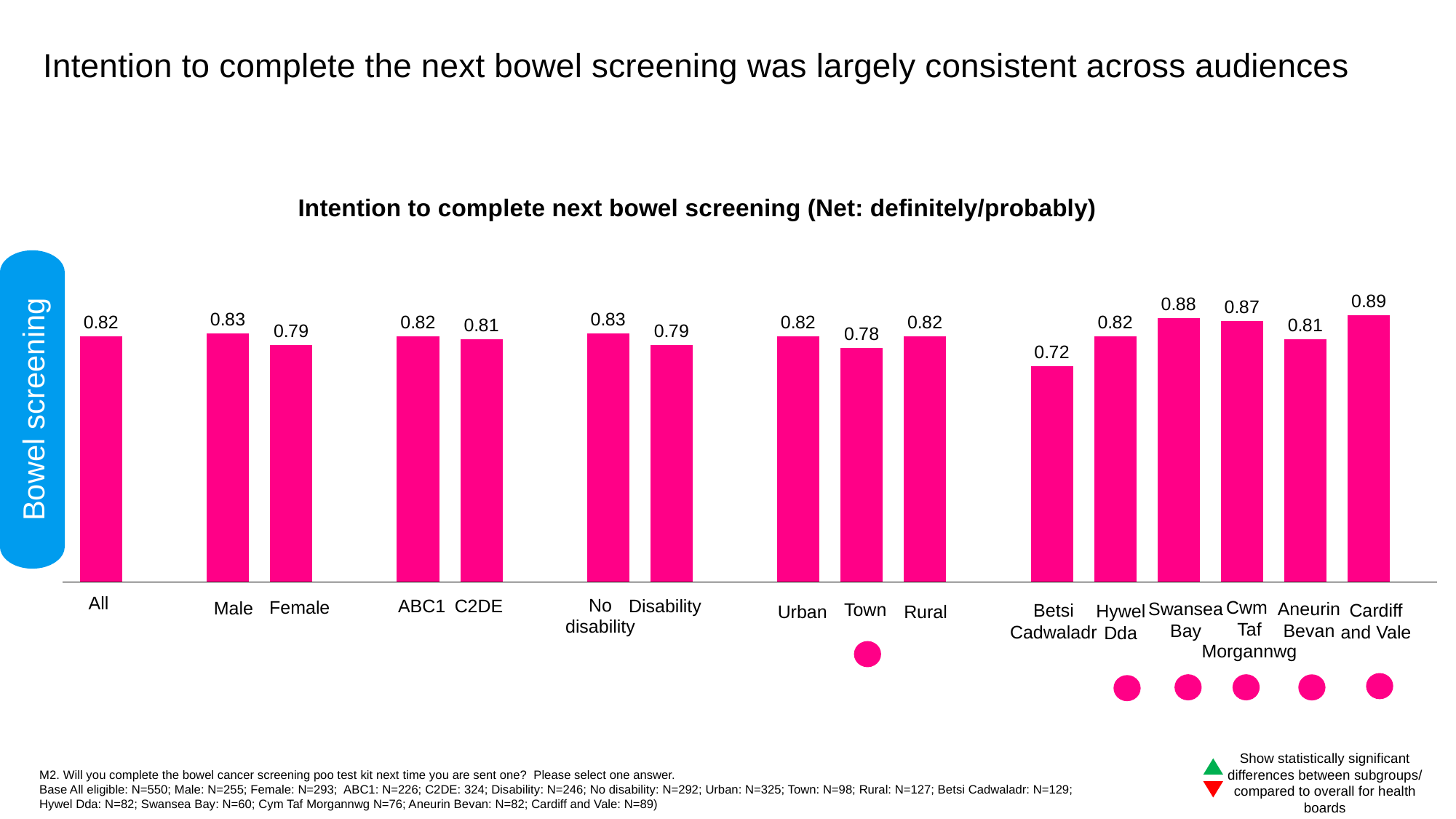
What is the difference between the values for Male and Female? 0.04 What kind of chart is shown on the slide? Bar chart What is the title of the chart? Intention to complete next bowel screening (Net: definitely/probably) What is the value for Betsi Cadwaladr? 0.72 What is the value for Swansea Bay? 0.88 Which category has the lowest value? Betsi Cadwaladr What is the value for Town? 0.78 What is the difference between the values for Cardiff and Vale and Betsi Cadwaladr? 0.17 Which category has the highest value? Cardiff and Vale How many bars are plotted in the chart? 16 What is the value for the All category? 0.82 Which is larger, the value for Urban or the value for Town? Urban